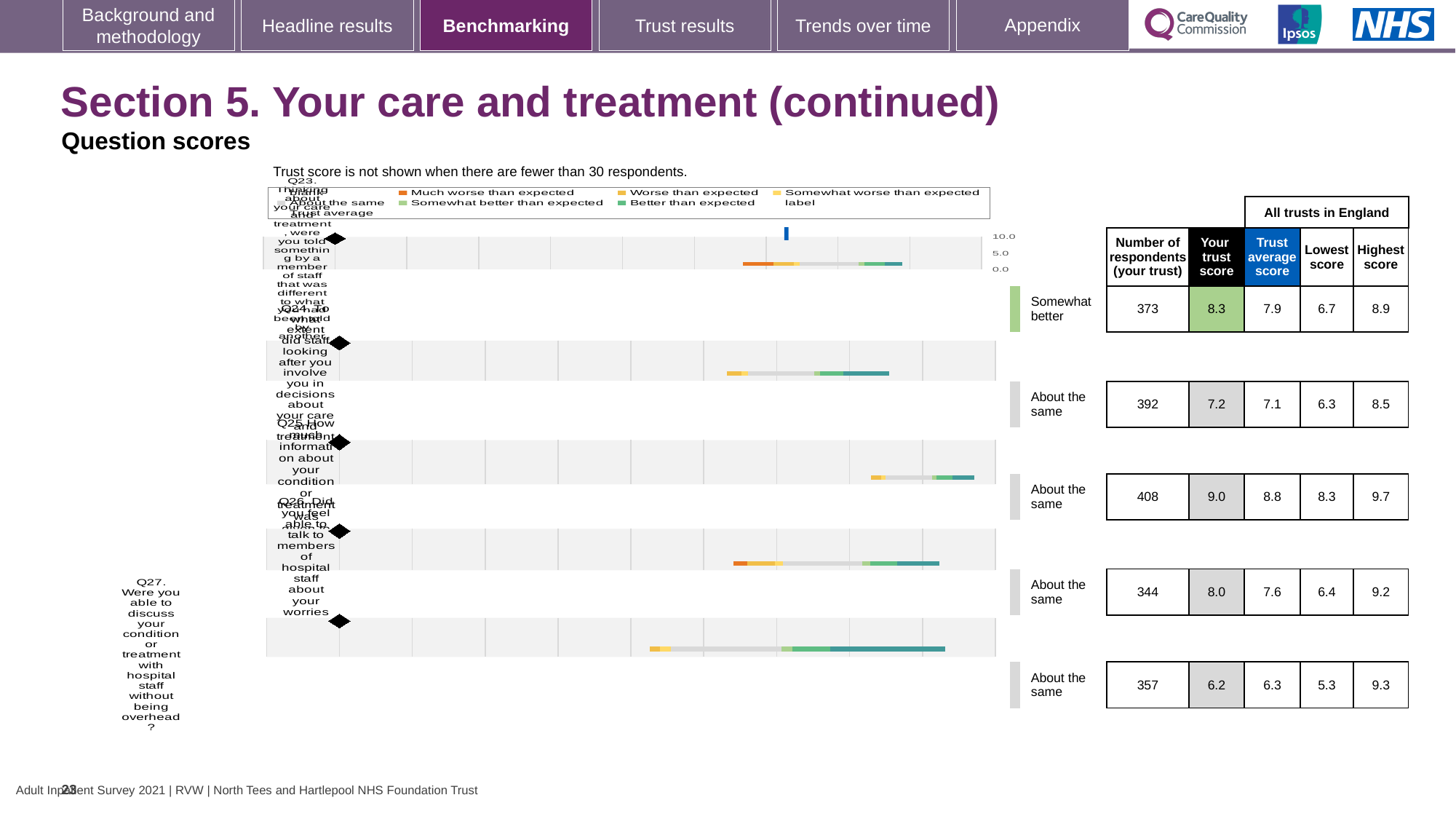
How many questions (Q23 to Q27) are plotted in the chart? 5 Which question has the lowest "Your trust score"? Q27 What kind of chart is shown on the slide? bar chart According to the note above the chart, when is the trust score not shown? When there are fewer than 30 respondents What is the "Highest score" across all trusts in England for Q26? 9.2 Which colour does the legend use for "Much worse than expected"? orange For Q24, which is larger: "Your trust score" or the "Trust average score"? Your trust score Which question has the highest "Your trust score"? Q25 For Q23, what is the difference between "Your trust score" and the "Trust average score"? 0.4 How many respondents are listed for Q27? 357 What benchmark category is shown for Q23? Somewhat better What is the "Your trust score" for Q23? 8.3